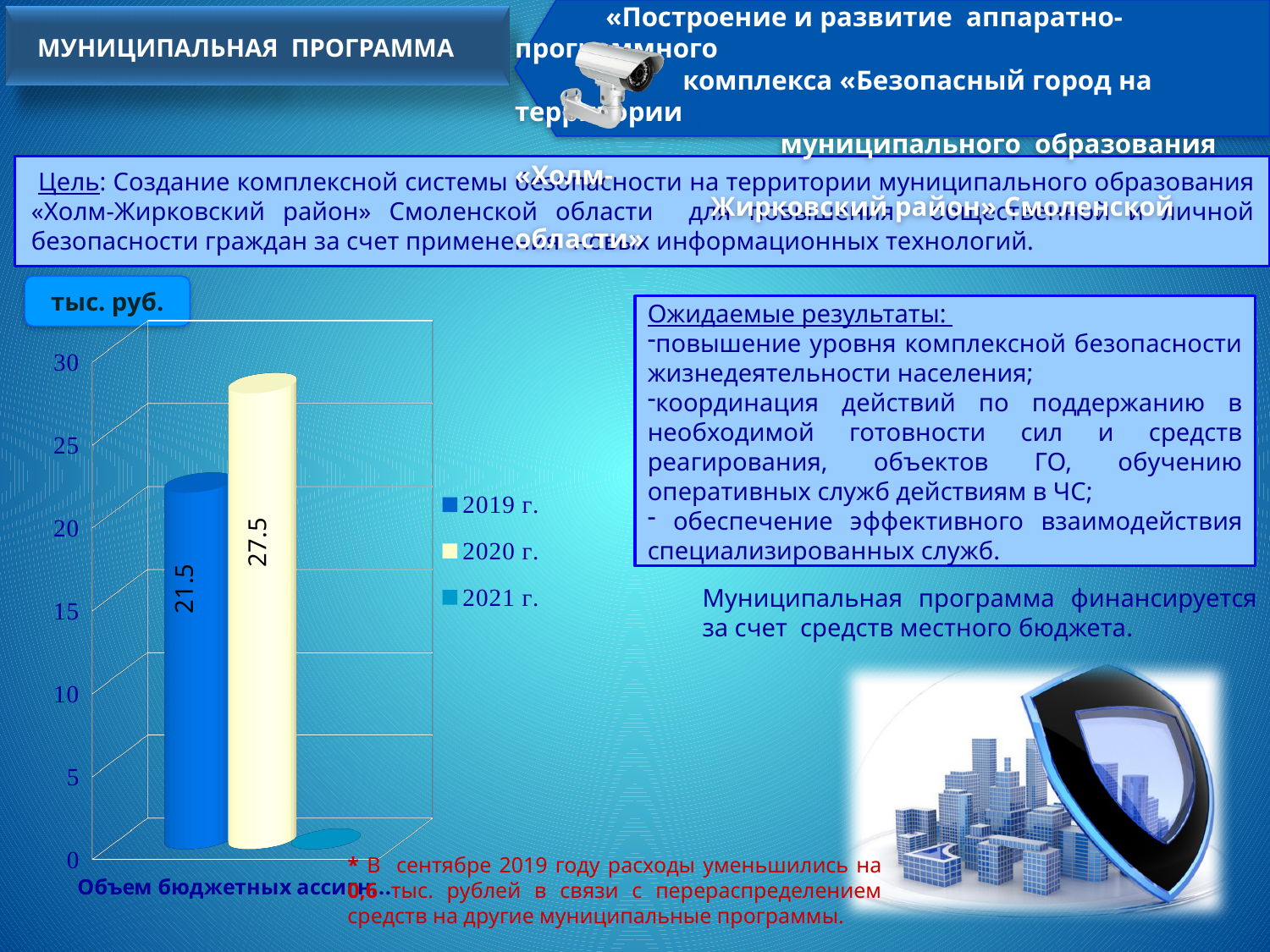
Is the value for 2020 г. in the bar chart greater or less than 25? greater What is the value for the 2019 г. series in the bar chart? 21.5 What is the difference between the 2020 г. value and the 2019 г. value in the bar chart? 6 What is the value for the 2020 г. series in the bar chart? 27.5 What unit is indicated for the values in the bar chart? тыс. руб. Is the value for 2020 г. in the bar chart greater or less than 30? less Which series has the highest value in the bar chart? 2020 г. How many series does the legend of the bar chart list? 3 Which is larger in the bar chart, the value for 2019 г. or the value for 2020 г.? 2020 г. What colour is the bar for the 2019 г. series in the chart? blue What kind of chart is shown on the slide? bar chart Is the value for 2019 г. in the bar chart greater or less than 20? greater